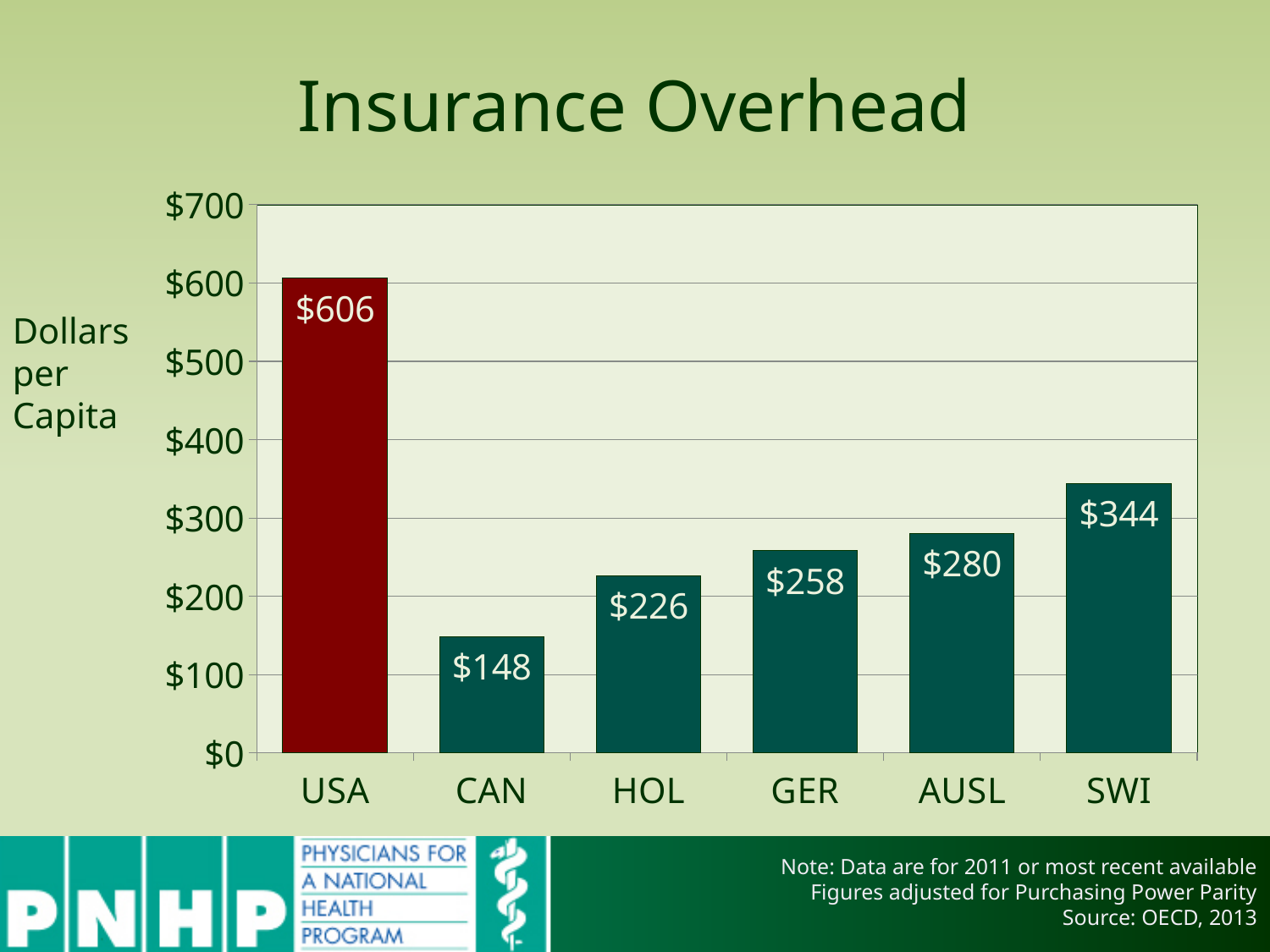
Which country has the lowest insurance overhead per capita? CAN What is the insurance overhead value for CAN? $148 Which is larger, the value for AUSL or the value for GER? AUSL What kind of chart is shown on the slide? bar chart What is the insurance overhead value for USA? $606 What is the difference between the GER and HOL values? $32 Which country has the highest insurance overhead per capita? USA Is the value for HOL greater or less than $300? less What is the title of the chart? Insurance Overhead What is the insurance overhead value for SWI? $344 How many countries are shown on the chart? 6 What is the difference between the USA and SWI values? $262